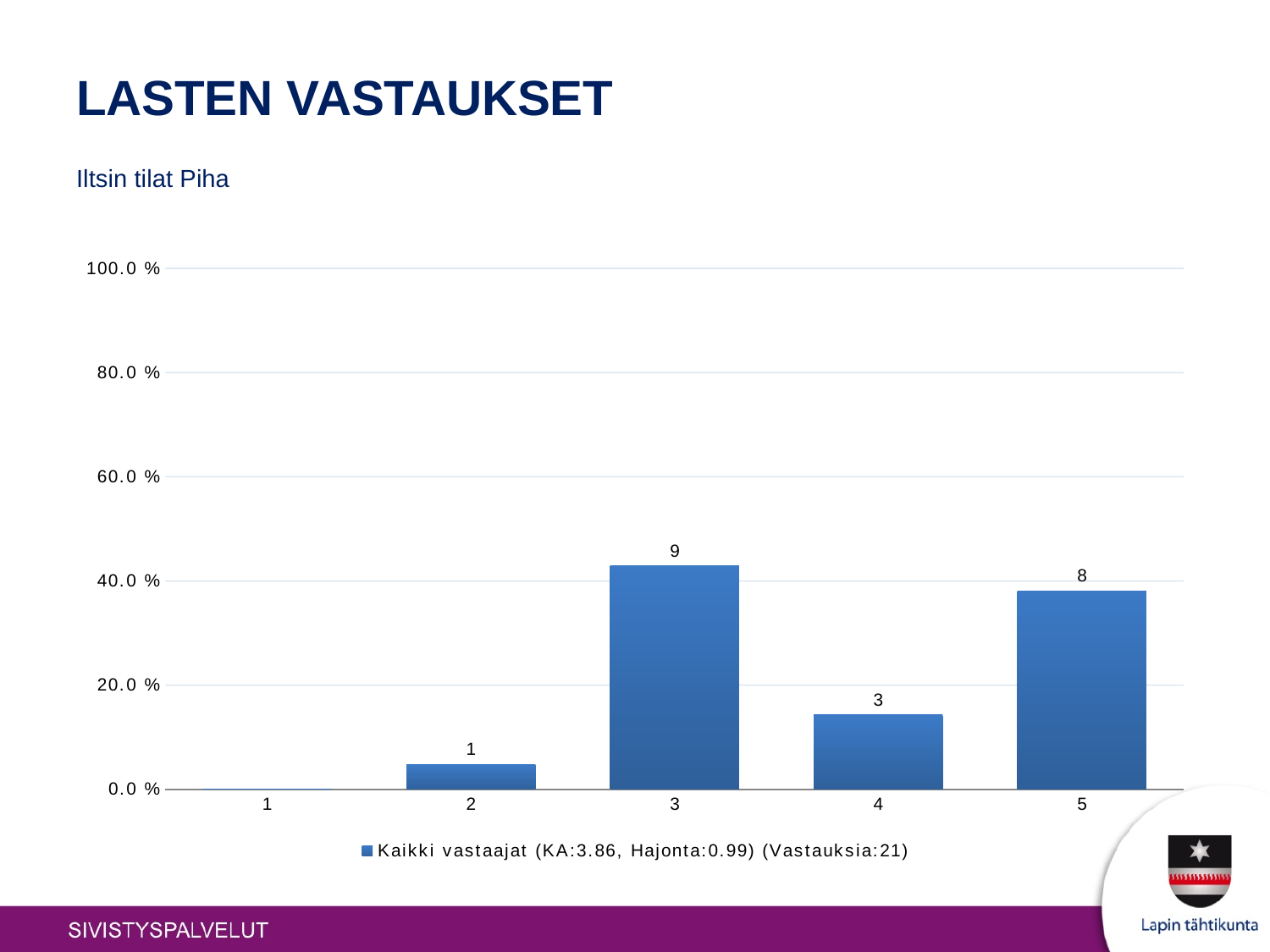
How many categories are shown on the x axis? 5 What is the legend entry for the series? Kaikki vastaajat (KA:3.86, Hajonta:0.99) (Vastauksia:21) What is the data label on the bar for category 2? 1 Which category has the highest bar? 3 What is the data label on the bar for category 5? 8 What is the data label on the bar for category 3? 9 What is the difference between the data labels for category 3 and category 4? 6 Which category has the lowest bar? 1 Which has the larger bar, category 4 or category 5? 5 What kind of chart is shown on the slide? bar chart What is the data label on the bar for category 4? 3 Is the value for category 3 greater or less than 40.0 %? greater